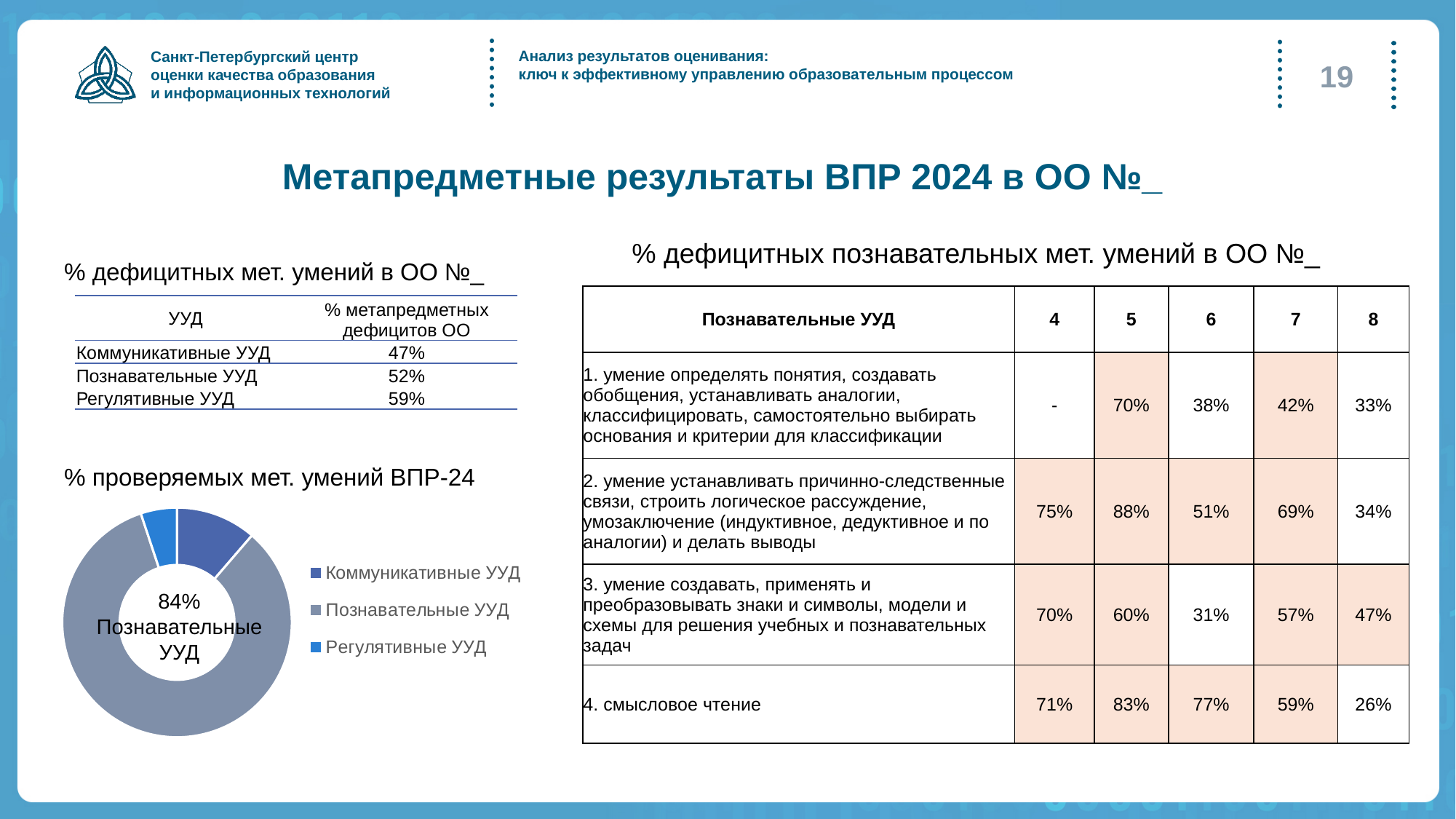
In the doughnut chart, which slice is larger: Коммуникативные УУД or Регулятивные УУД? Коммуникативные УУД Which category has the largest slice in the doughnut chart? Познавательные УУД What kind of chart is shown under the heading "% проверяемых мет. умений ВПР-24"? Doughnut (pie) chart How many slices does the doughnut chart have? 3 How many entries does the legend of the doughnut chart list? 3 What share of the doughnut chart is labelled for Познавательные УУД? 84% What is the title of the doughnut chart on the slide? % проверяемых мет. умений ВПР-24 Which category has the smallest slice in the doughnut chart? Регулятивные УУД Which legend entry of the doughnut chart is shown in grey? Познавательные УУД